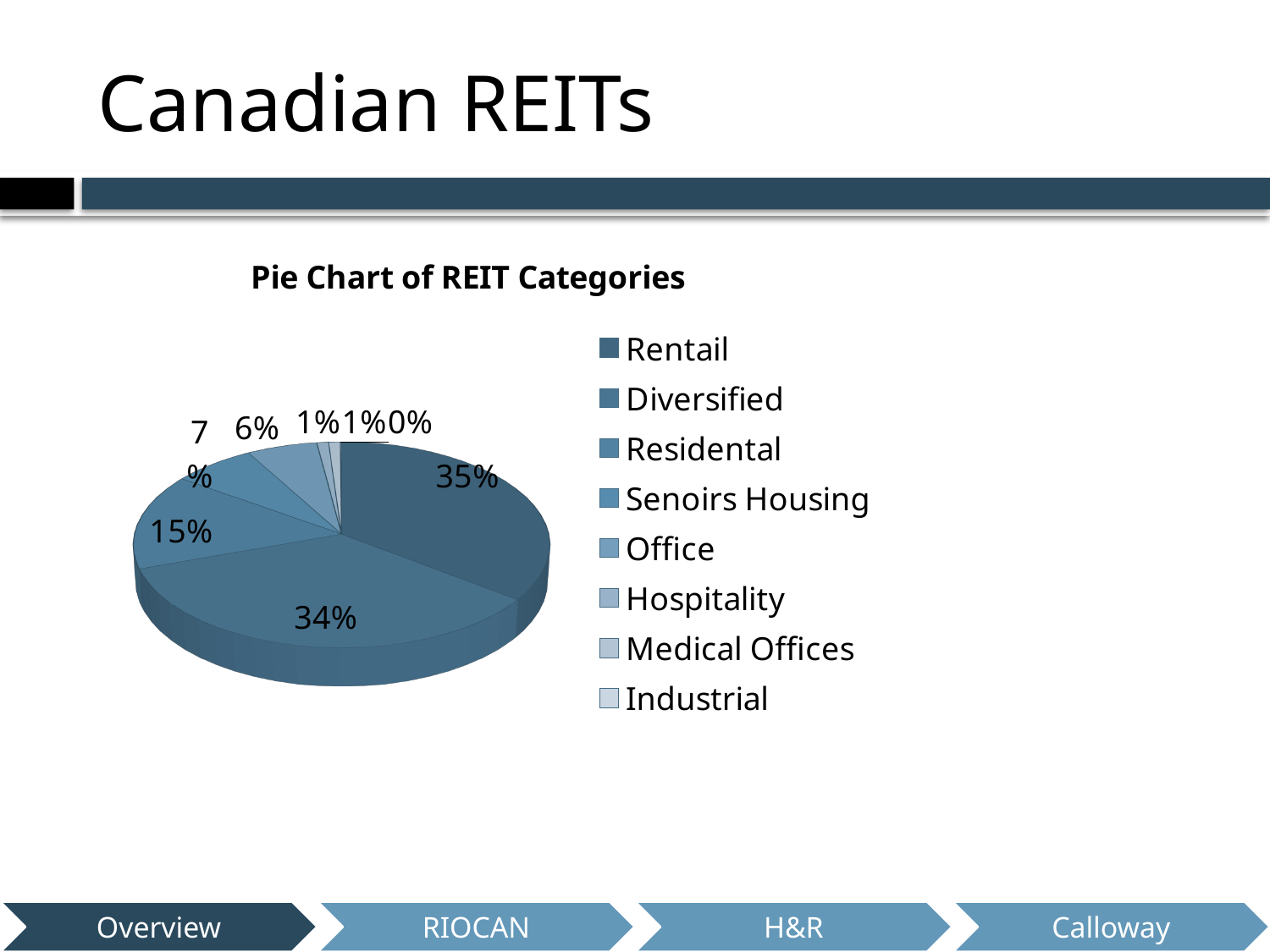
What is the title of the chart? Pie Chart of REIT Categories What share of the pie does Office have? 6% What share of the pie does Rentail have? 35% How many categories does the pie chart's legend list? 8 What share of the pie does Senoirs Housing have? 7% What share of the pie does Industrial have? 0% What share of the pie does Residental have? 15% What share of the pie does Diversified have? 34% Which category has the smallest share of the pie? Industrial What is the difference between the Rentail share and the Residental share? 20% Which category has the largest share of the pie? Rentail What type of chart is shown on the slide? pie chart